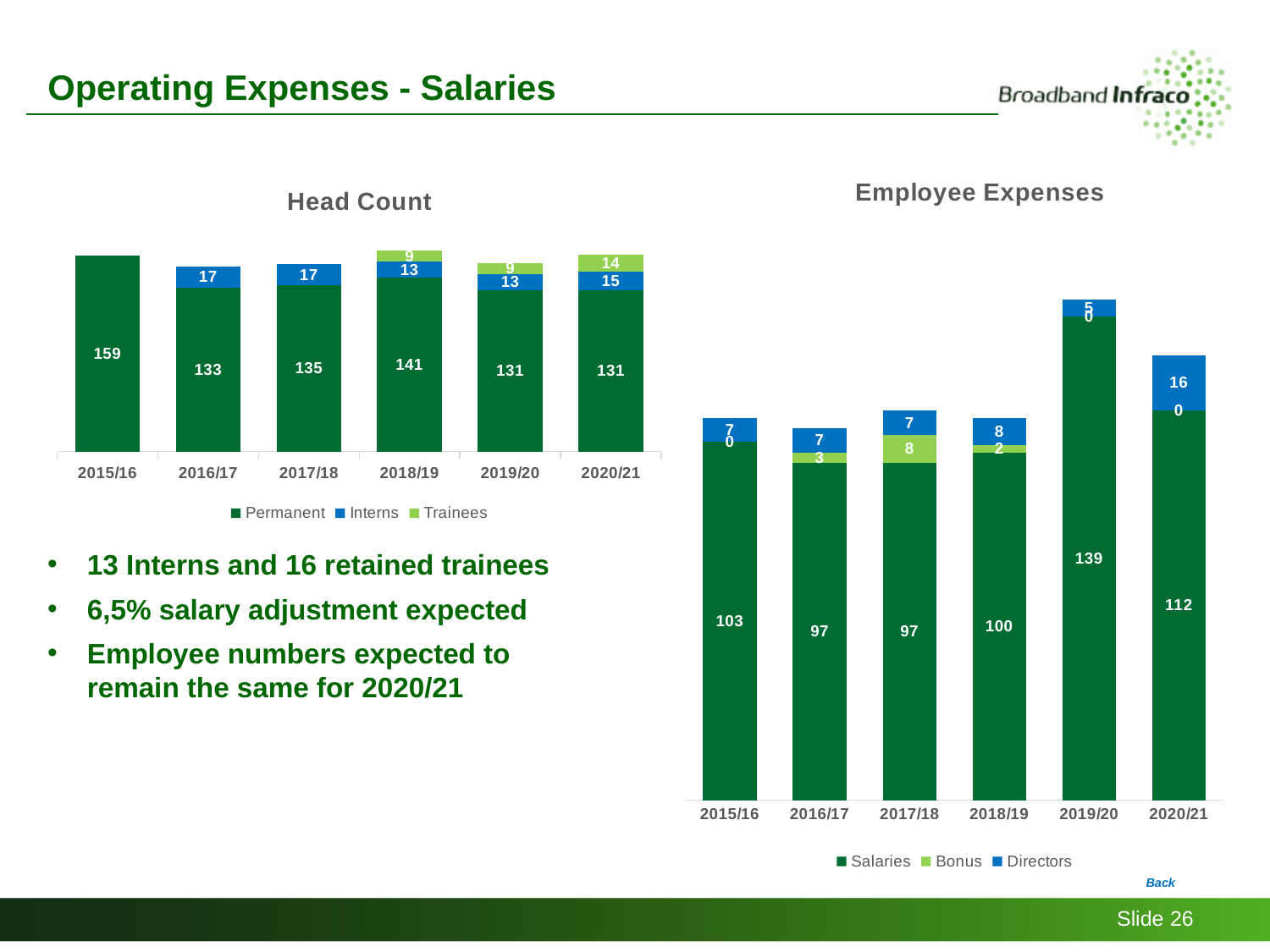
In the Employee Expenses chart, which year has the highest Salaries value? 2019/20 In the Head Count chart, what is the total head count for 2020/21 across Permanent, Interns and Trainees? 160 How many years are shown on the x axis of the Employee Expenses chart? 6 In the Employee Expenses chart, what is the total of Salaries, Bonus and Directors for 2016/17? 107 In the Head Count chart, what is the Permanent head count for 2015/16? 159 How many series does the legend of the Head Count chart list? 3 In the Head Count chart, how many Interns are shown for 2020/21? 15 In the Employee Expenses chart, what is the Salaries value for 2019/20? 139 In the Head Count chart, which year has the highest Permanent head count? 2015/16 In the Employee Expenses chart, what is the Directors value for 2020/21? 16 In the Employee Expenses chart, what is the Bonus value for 2017/18? 8 In the Head Count chart, by how much did the Permanent head count fall from 2015/16 to 2016/17? 26